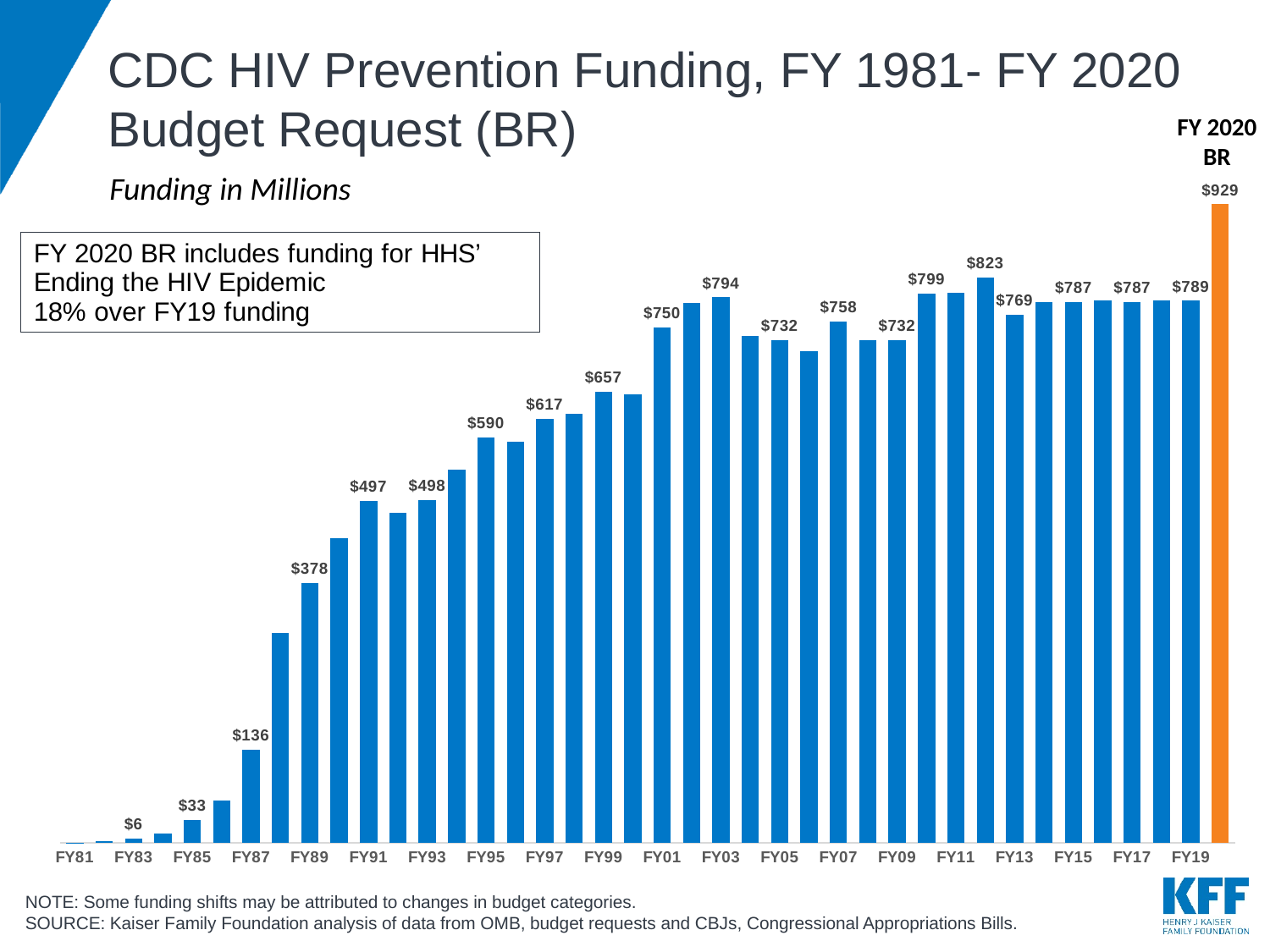
What is the difference between the FY87 and FY85 values? $103 What is the funding value shown for FY89? $378 What is the funding value shown for FY03? $794 What is the highest value shown for any fiscal year before the FY 2020 BR? $823 Which fiscal year has the lowest funding value on the chart? FY81 Which is larger, the value for FY11 or the value for FY13? FY11 Which bar has the highest value on the chart? FY 2020 BR What kind of chart is shown on the slide? Bar chart What is the value for the FY 2020 BR bar? $929 How much larger is the FY 2020 BR value than the FY19 value? $140 What colour is the FY 2020 BR bar? Orange What is the funding value shown for FY15? $787